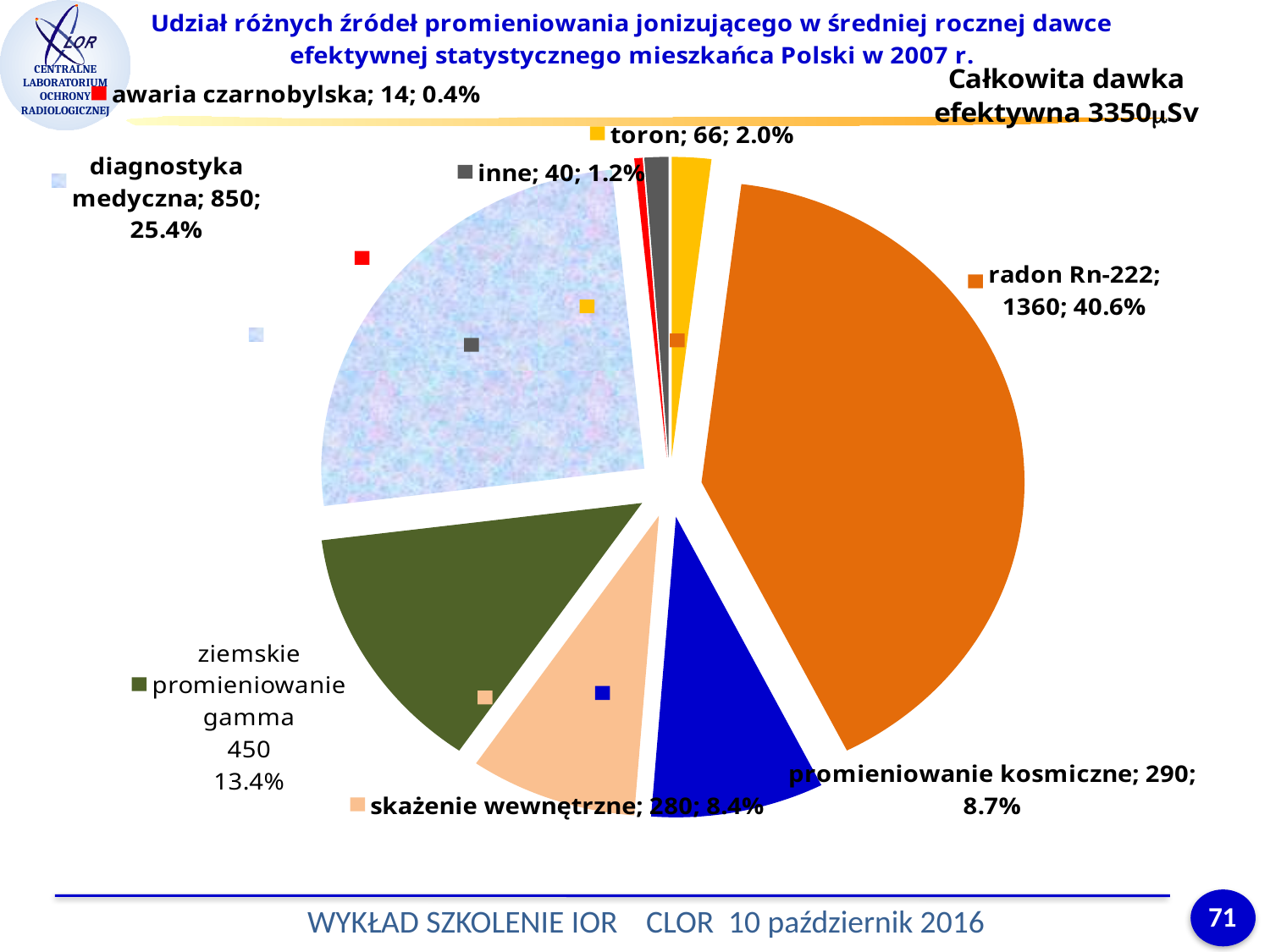
Which source has the largest share of the pie? radon Rn-222 What is the difference between the values for radon Rn-222 and diagnostyka medyczna? 510 Which is larger, the value for promieniowanie kosmiczne or skażenie wewnętrzne? promieniowanie kosmiczne What percentage share is shown for inne? 1.2% What kind of chart is shown on the slide? pie chart What total effective dose is stated on the slide? 3350 µSv What percentage share is shown for diagnostyka medyczna? 25.4% Which source has the smallest share of the pie? awaria czarnobylska How many slices does the pie chart have? 8 What percentage share is shown for toron? 2.0% What value is shown for radon Rn-222? 1360 What value is shown for ziemskie promieniowanie gamma? 450